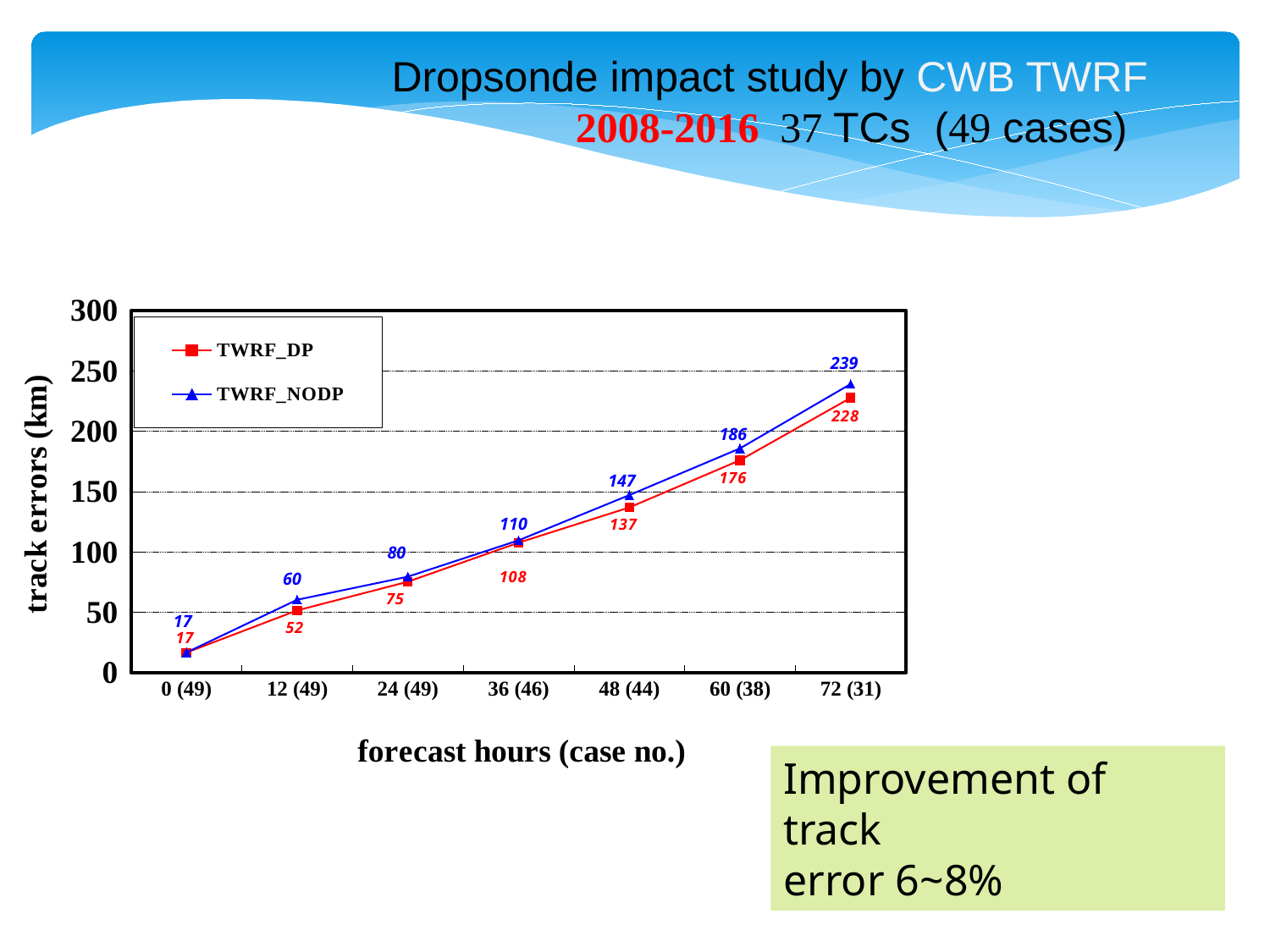
What is the difference between the TWRF_NODP and TWRF_DP track errors at 60 (38) forecast hours? 10 How many forecast hour categories are shown on the x axis? 7 What is the difference between the TWRF_NODP and TWRF_DP track errors at 72 (31) forecast hours? 11 What kind of chart is shown on the slide? line chart Do the TWRF_DP track errors rise or fall as forecast hours increase? rise Which series has the larger track error at 24 (49) forecast hours, TWRF_DP or TWRF_NODP? TWRF_NODP What is the track error for TWRF_DP at 48 (44) forecast hours? 137 At which forecast hour is the TWRF_DP track error lowest? 0 (49) What is the track error for TWRF_DP at 12 (49) forecast hours? 52 At which forecast hour is the TWRF_NODP track error highest? 72 (31) What is the track error for TWRF_NODP at 72 (31) forecast hours? 239 How many series does the legend list? 2